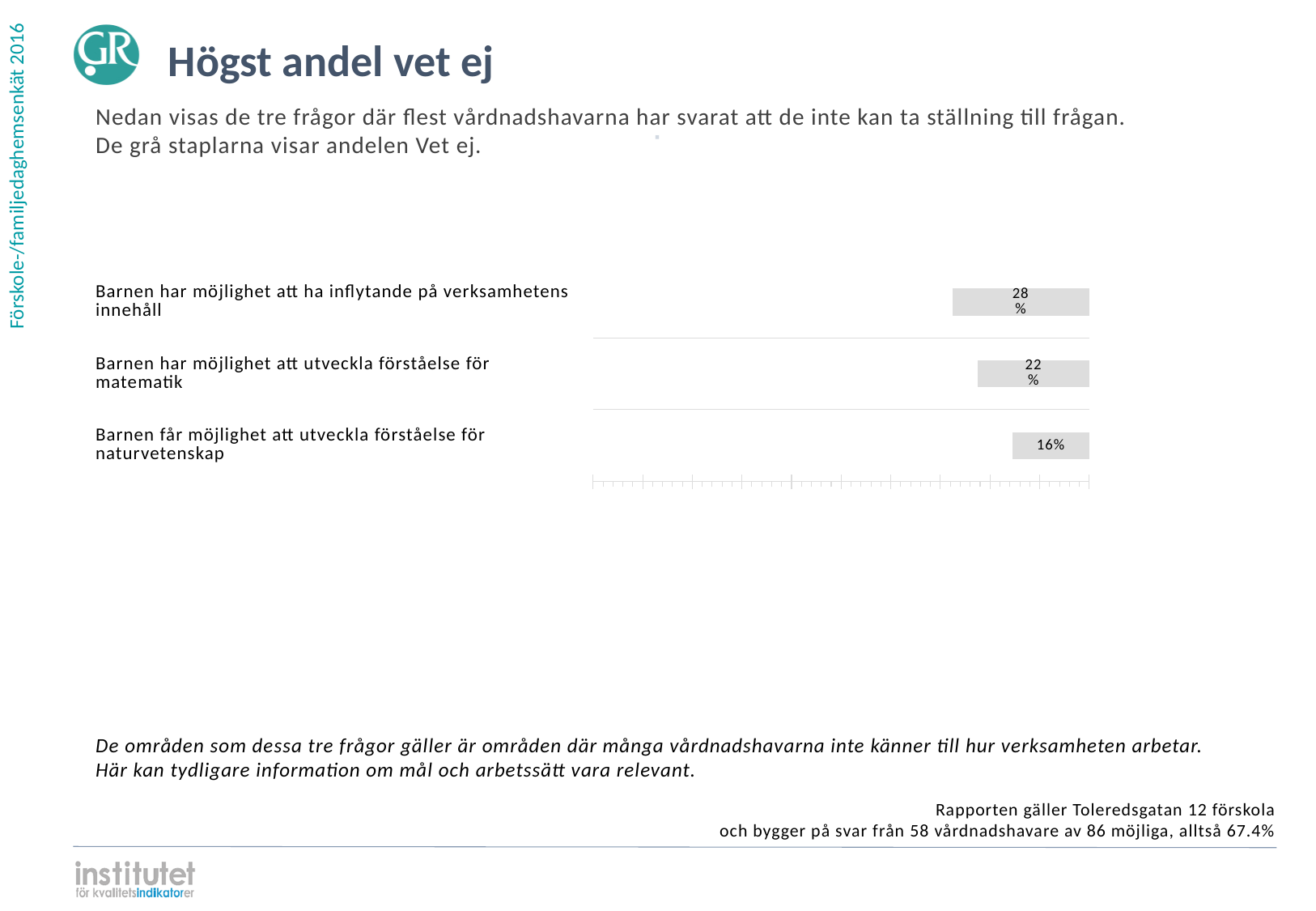
What is the difference in Vet ej share between the question about matematik and the question about naturvetenskap? 6% Which question has the lowest Vet ej share? Barnen får möjlighet att utveckla förståelse för naturvetenskap Which question has the highest Vet ej share? Barnen har möjlighet att ha inflytande på verksamhetens innehåll What is the Vet ej share for "Barnen har möjlighet att utveckla förståelse för matematik"? 22% What colour are the bars showing the Vet ej share? Grey What is the Vet ej share for "Barnen får möjlighet att utveckla förståelse för naturvetenskap"? 16% What kind of chart is shown on the slide? Bar chart What is the difference in Vet ej share between the question about inflytande på verksamhetens innehåll and the question about naturvetenskap? 12% What is the title of the slide? Högst andel vet ej What is the Vet ej share for "Barnen har möjlighet att ha inflytande på verksamhetens innehåll"? 28% Which has a larger Vet ej share: the question about matematik or the question about naturvetenskap? Barnen har möjlighet att utveckla förståelse för matematik How many questions are shown in the chart? 3